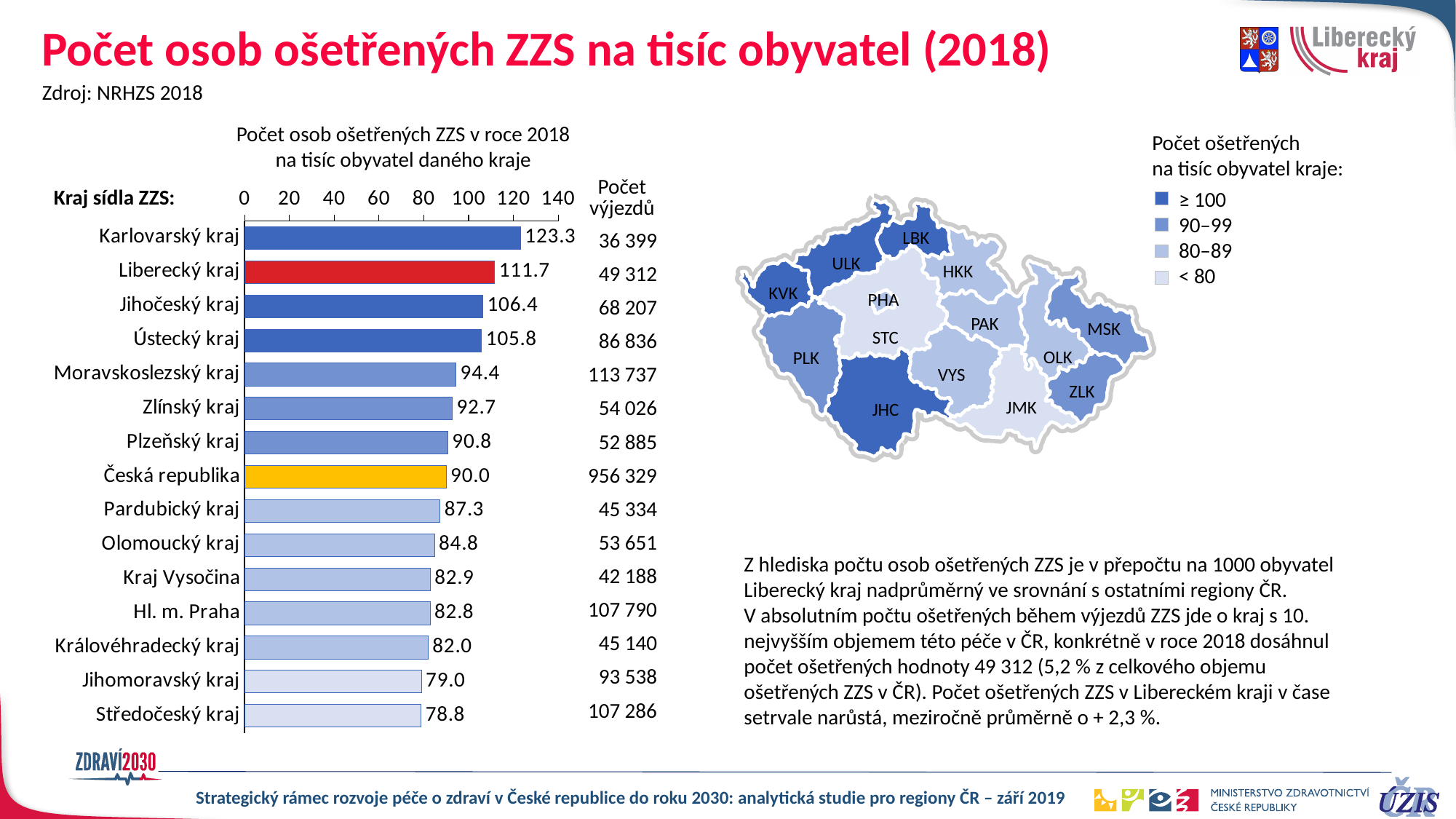
Which has a larger value, Jihočeský kraj or Ústecký kraj? Jihočeský kraj Is the value for Moravskoslezský kraj greater or less than 80? greater What is the value for Středočeský kraj in the bar chart? 78.8 What is the value for Liberecký kraj in the bar chart? 111.7 Which category has the lowest value in the bar chart? Středočeský kraj What is the value for Česká republika in the bar chart? 90.0 What is the value for Karlovarský kraj in the bar chart? 123.3 What is the difference between the values for Liberecký kraj and Česká republika? 21.7 Which category has the highest value in the bar chart? Karlovarský kraj What is the difference between the values for Karlovarský kraj and Liberecký kraj? 11.6 What colour is the bar for Liberecký kraj? Red How many categories are shown in the bar chart? 15